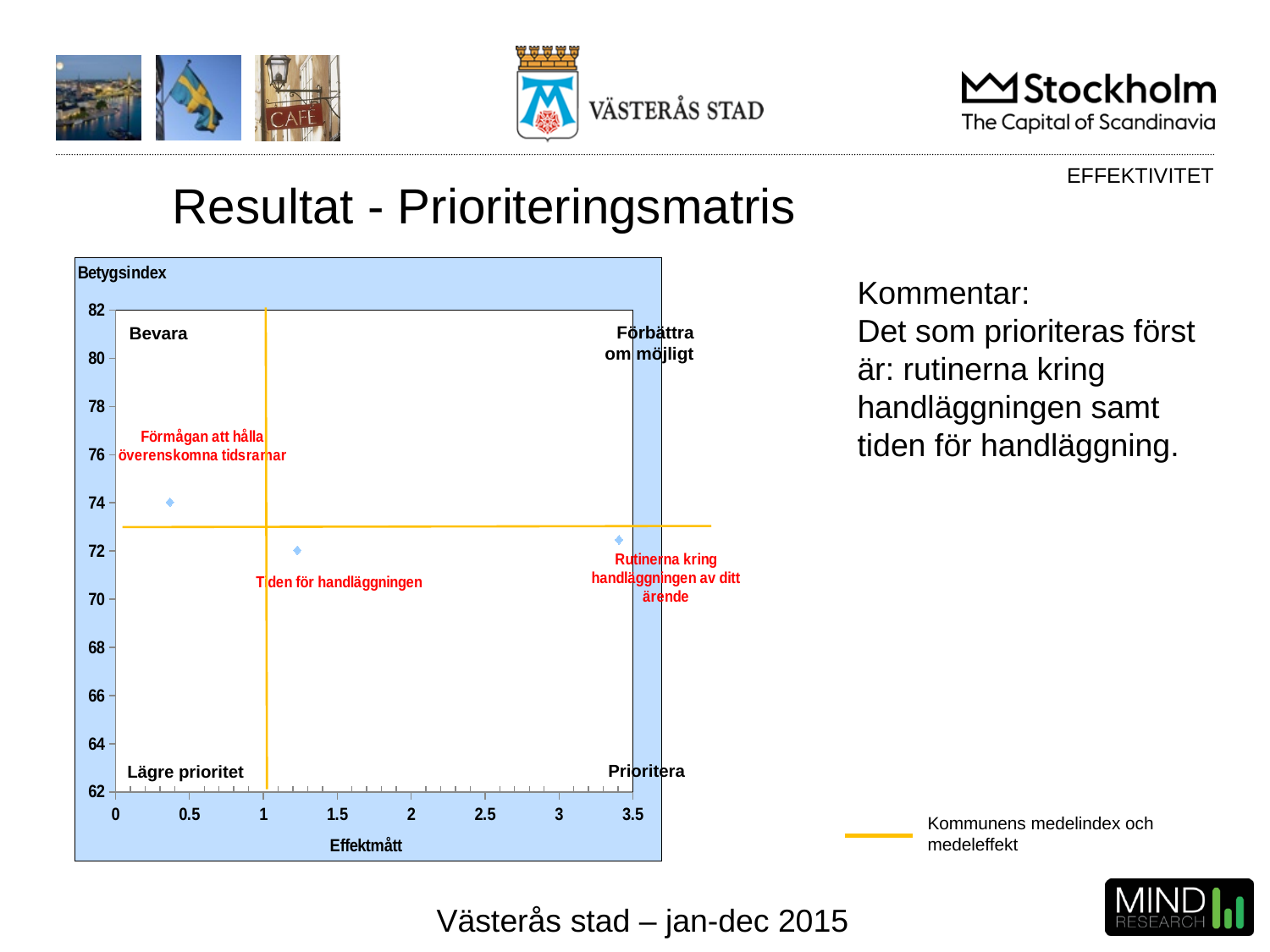
Which point has the highest Effektmått value? Rutinerna kring handläggningen av ditt ärende Which has a higher Betygsindex: Förmågan att hålla överenskomna tidsramar or Tiden för handläggningen? Förmågan att hålla överenskomna tidsramar Which point has the lowest Effektmått value? Förmågan att hålla överenskomna tidsramar Is the Effektmått value for Förmågan att hålla överenskomna tidsramar greater or less than 0.5? less What is the label of the bottom-right quadrant of the chart? Prioritera How many data points are plotted in the chart? 3 Is the Effektmått value for Rutinerna kring handläggningen av ditt ärende greater or less than 3? greater Is the Betygsindex value for Tiden för handläggningen greater or less than 74? less Which point has the highest Betygsindex value? Förmågan att hålla överenskomna tidsramar What is the label of the x axis of the chart? Effektmått What kind of chart is shown on the slide? Scatter chart